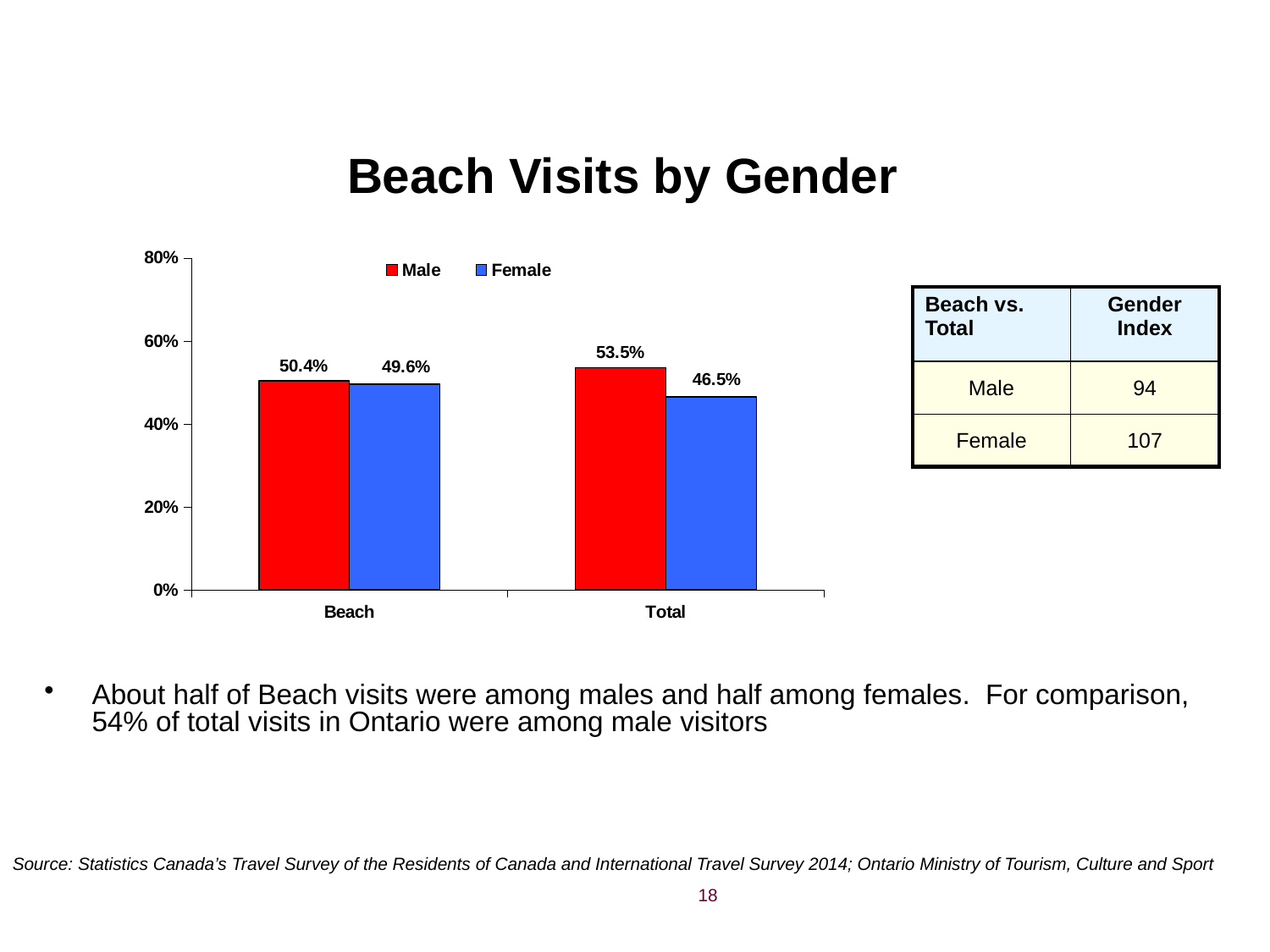
What is the difference between the Male and Female values for Total? 7.0% Which category has the highest Male value? Total What colour represents the Female series? blue What is the Female value for Total? 46.5% What is the Male value for Beach? 50.4% How many categories are shown on the x axis? 2 What kind of chart is shown? bar chart How many series does the legend list? 2 What is the Female value for Beach? 49.6% Which category has the lowest Female value? Total Which is larger for Total, the Male value or the Female value? Male What is the Male value for Total? 53.5%